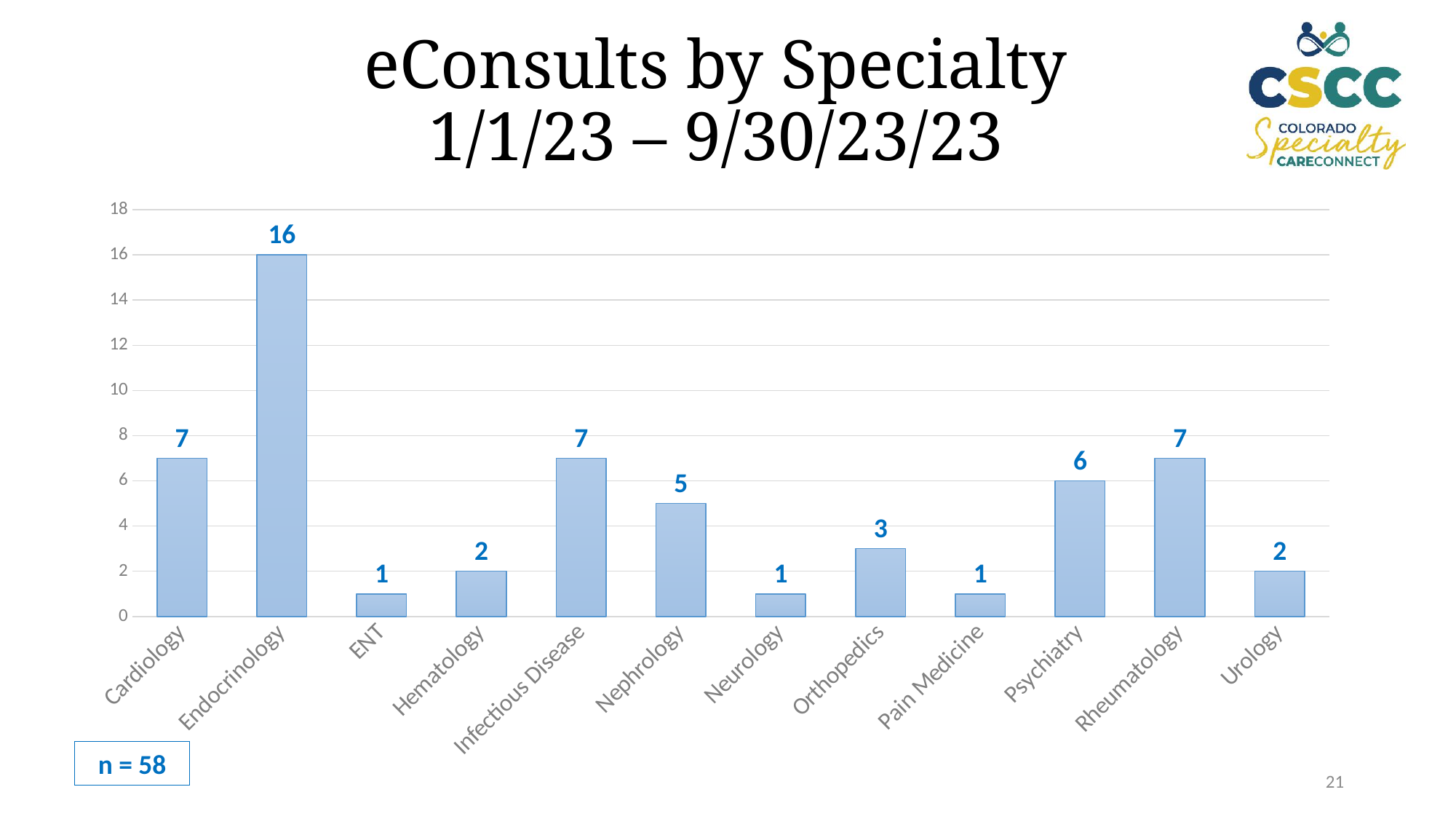
What is the value shown for Orthopedics? 3 Is the value for Endocrinology greater or less than 14? greater What kind of chart is shown on the slide? Bar chart What total sample size (n) is shown on the slide? n = 58 What is the difference between the values for Psychiatry and Hematology? 4 What is the difference between the values for Endocrinology and Cardiology? 9 Which specialty has the highest number of eConsults? Endocrinology How many eConsults were there for Endocrinology? 16 How many specialties are shown on the x axis? 12 What is the title of the chart on the slide? eConsults by Specialty 1/1/23 – 9/30/23/23 Which is larger, the value for Nephrology or the value for Psychiatry? Psychiatry What is the value shown for Nephrology? 5